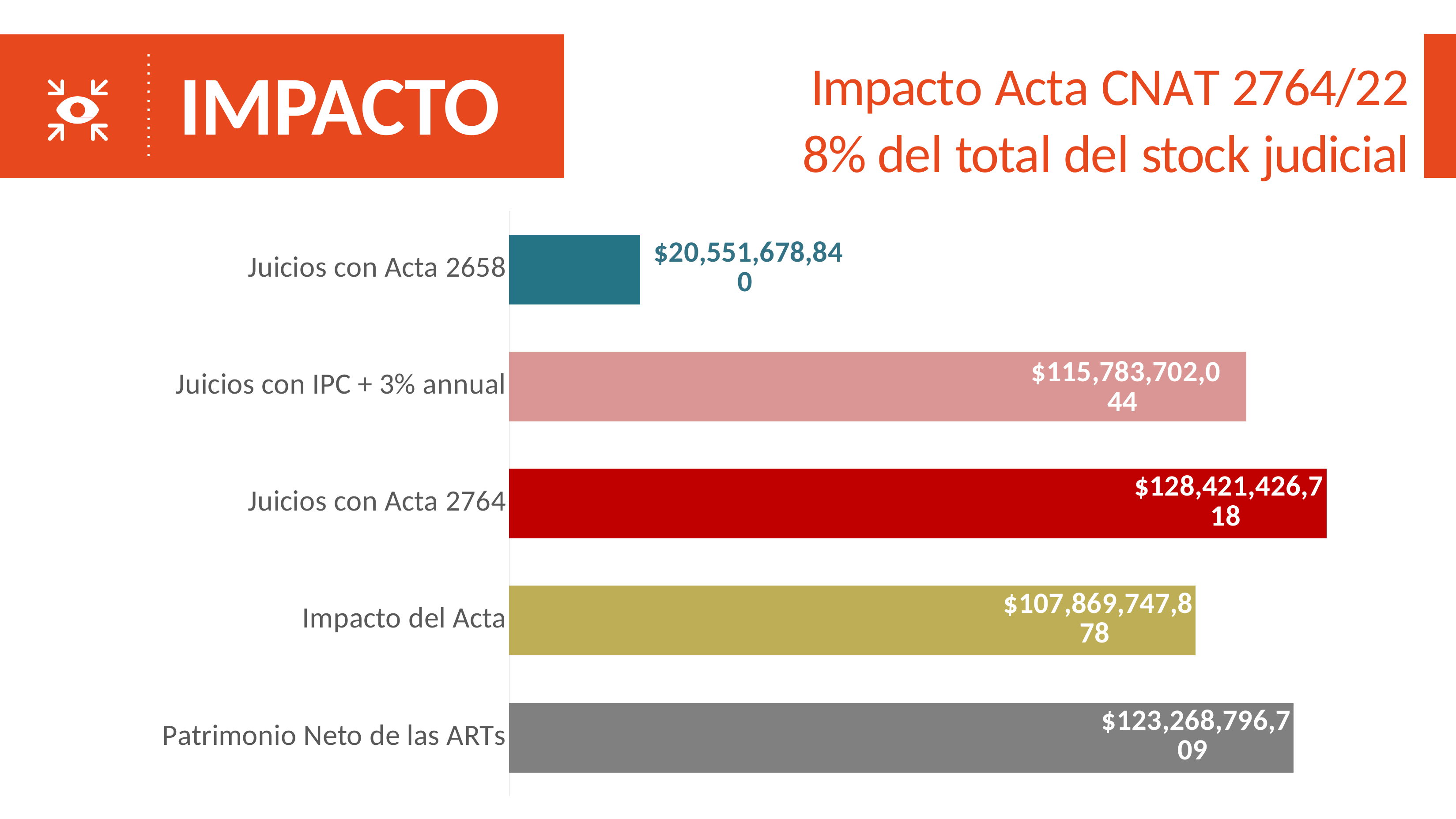
Which is larger, Juicios con IPC + 3% annual or Impacto del Acta? Juicios con IPC + 3% annual What is the value for Juicios con IPC + 3% annual? $115,783,702,044 What is the difference between Juicios con Acta 2764 and Juicios con Acta 2658? $107,869,747,878 What is the value for Patrimonio Neto de las ARTs? $123,268,796,709 Which category has the lowest value? Juicios con Acta 2658 What kind of chart is shown on the slide? Bar chart Which category has the highest value? Juicios con Acta 2764 What is the value for Juicios con Acta 2658? $20,551,678,840 How many categories are shown in the chart? 5 What is the value for Impacto del Acta? $107,869,747,878 What is the value for Juicios con Acta 2764? $128,421,426,718 What is the difference between Juicios con Acta 2764 and Patrimonio Neto de las ARTs? $5,152,630,009